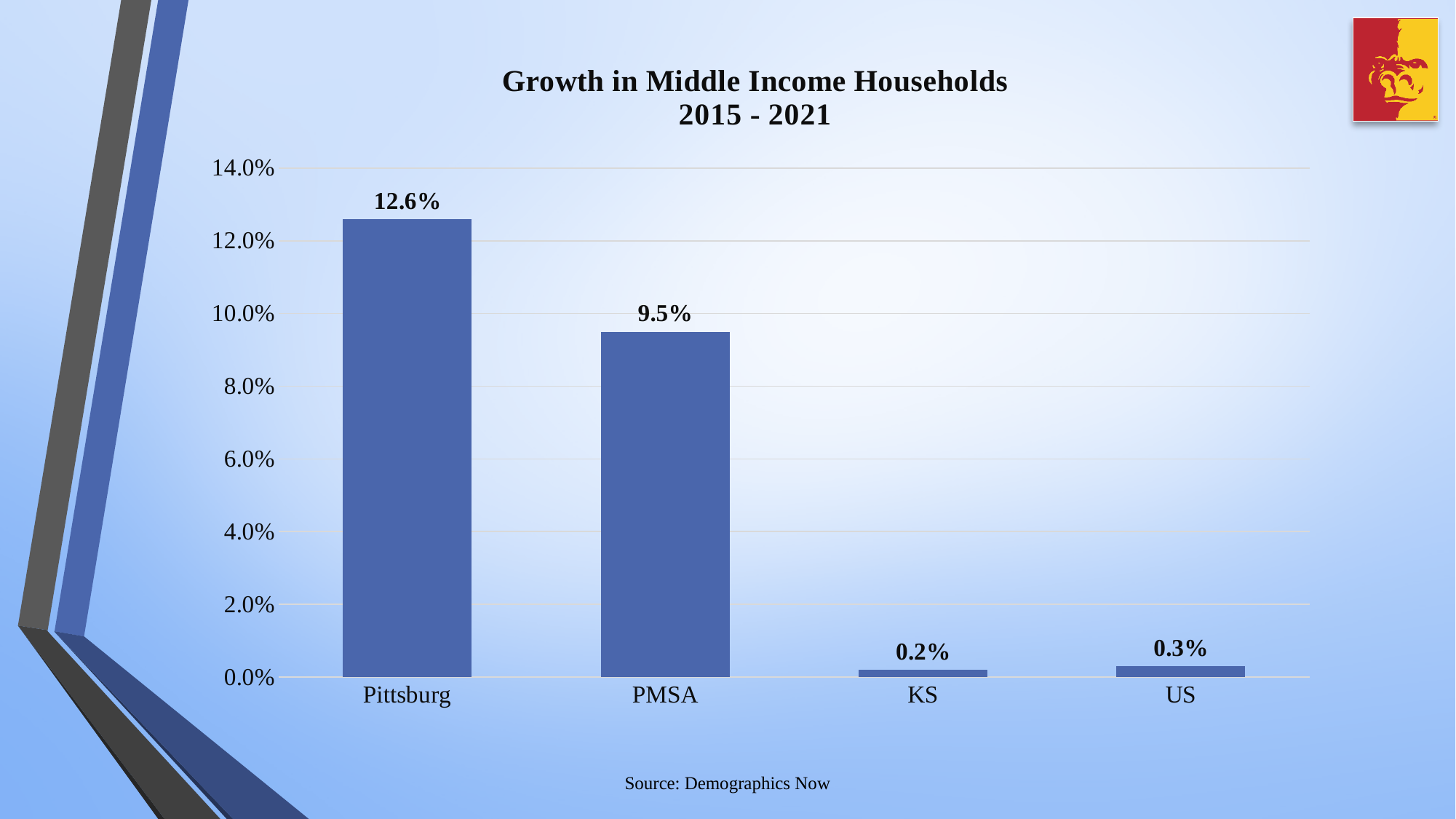
What kind of chart is shown on the slide? Bar chart How many categories are shown on the chart? 4 Which category has the highest growth in middle income households? Pittsburg What is the growth in middle income households for US? 0.3% What is the growth in middle income households for KS? 0.2% What is the growth in middle income households for Pittsburg? 12.6% What is the source cited for the chart? Demographics Now Is the value for PMSA greater or less than 10.0%? less Which has higher growth in middle income households, PMSA or US? PMSA Which category has the lowest growth in middle income households? KS What is the growth in middle income households for PMSA? 9.5% What is the difference between the growth for Pittsburg and PMSA? 3.1%